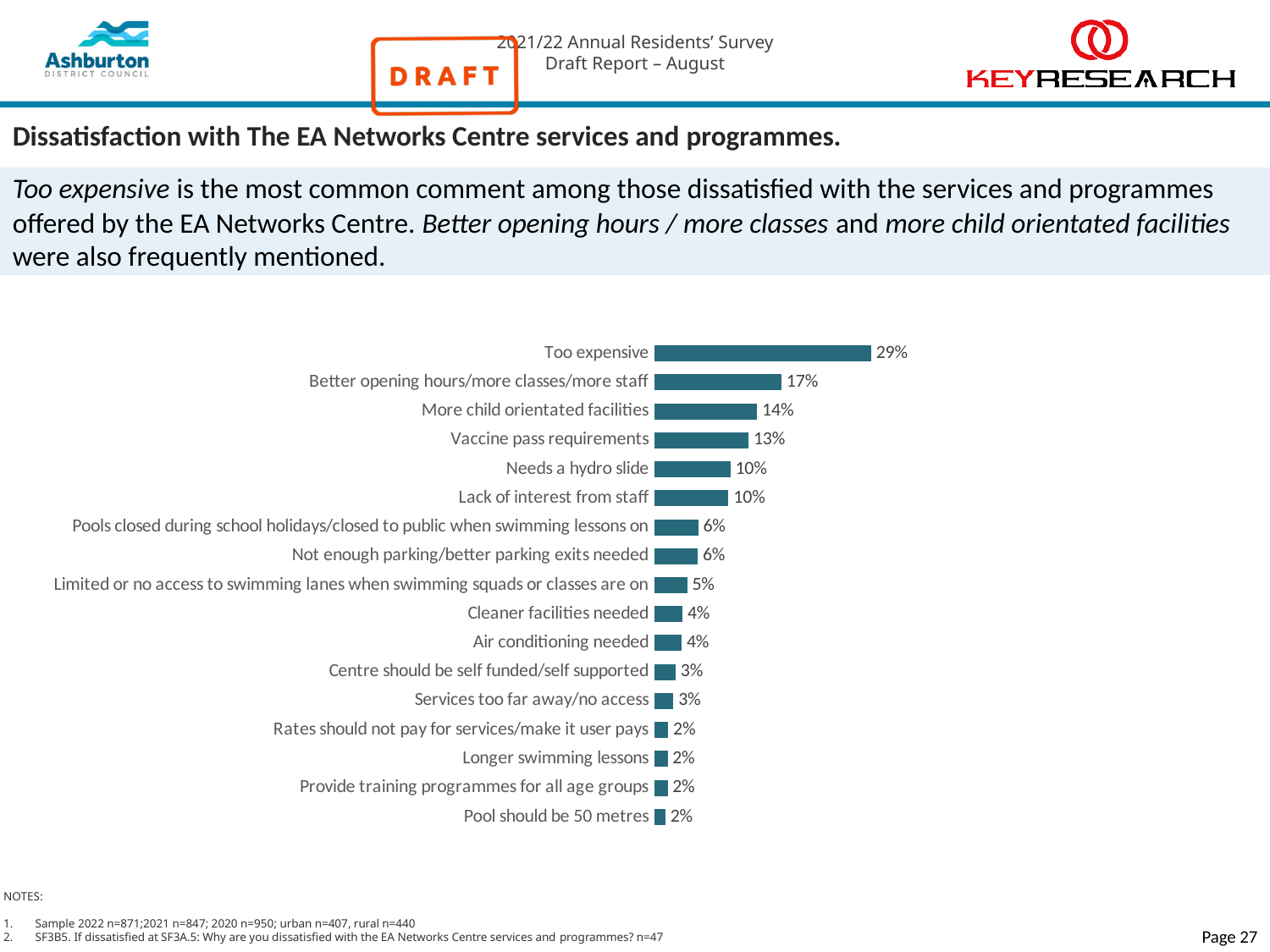
What is the difference between the values for 'Too expensive' and 'Better opening hours/more classes/more staff'? 12% What percentage of dissatisfied respondents mentioned 'Too expensive'? 29% How many categories are plotted in the chart? 17 Which category has the highest value in the chart? Too expensive What percentage is shown for 'Needs a hydro slide'? 10% Which is larger: 'Services too far away/no access' or 'Limited or no access to swimming lanes when swimming squads or classes are on'? Limited or no access to swimming lanes when swimming squads or classes are on What is the value shown for 'Vaccine pass requirements'? 13% What is the value for 'Cleaner facilities needed'? 4% What is the value shown for 'Pool should be 50 metres'? 2% What is the difference between 'More child orientated facilities' and 'Vaccine pass requirements'? 1% What type of chart is shown on the slide? Bar chart Which is larger: the value for 'Lack of interest from staff' or the value for 'Not enough parking/better parking exits needed'? Lack of interest from staff